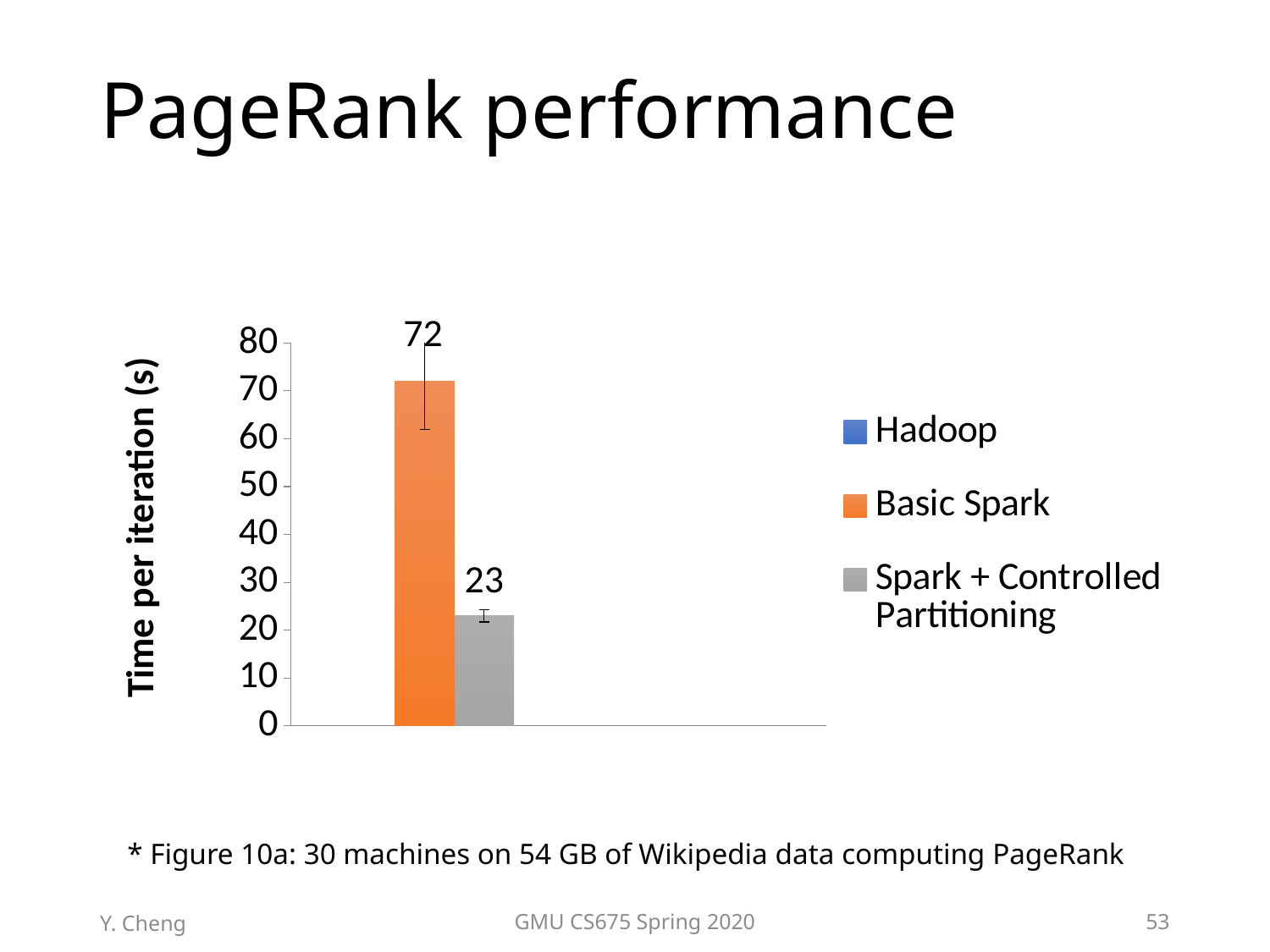
How many series does the legend list? 3 How many bars are plotted in the chart? 2 What is the time per iteration for Spark + Controlled Partitioning? 23 What colour is the Basic Spark bar? orange Is the value for Basic Spark greater or less than 60? greater Which has a higher time per iteration, Basic Spark or Spark + Controlled Partitioning? Basic Spark What is the time per iteration for Basic Spark? 72 Which plotted series has the shortest bar? Spark + Controlled Partitioning What is the label of the vertical axis? Time per iteration (s) What is the difference in time per iteration between Basic Spark and Spark + Controlled Partitioning? 49 What kind of chart is shown on the slide? bar chart Which plotted series has the tallest bar? Basic Spark